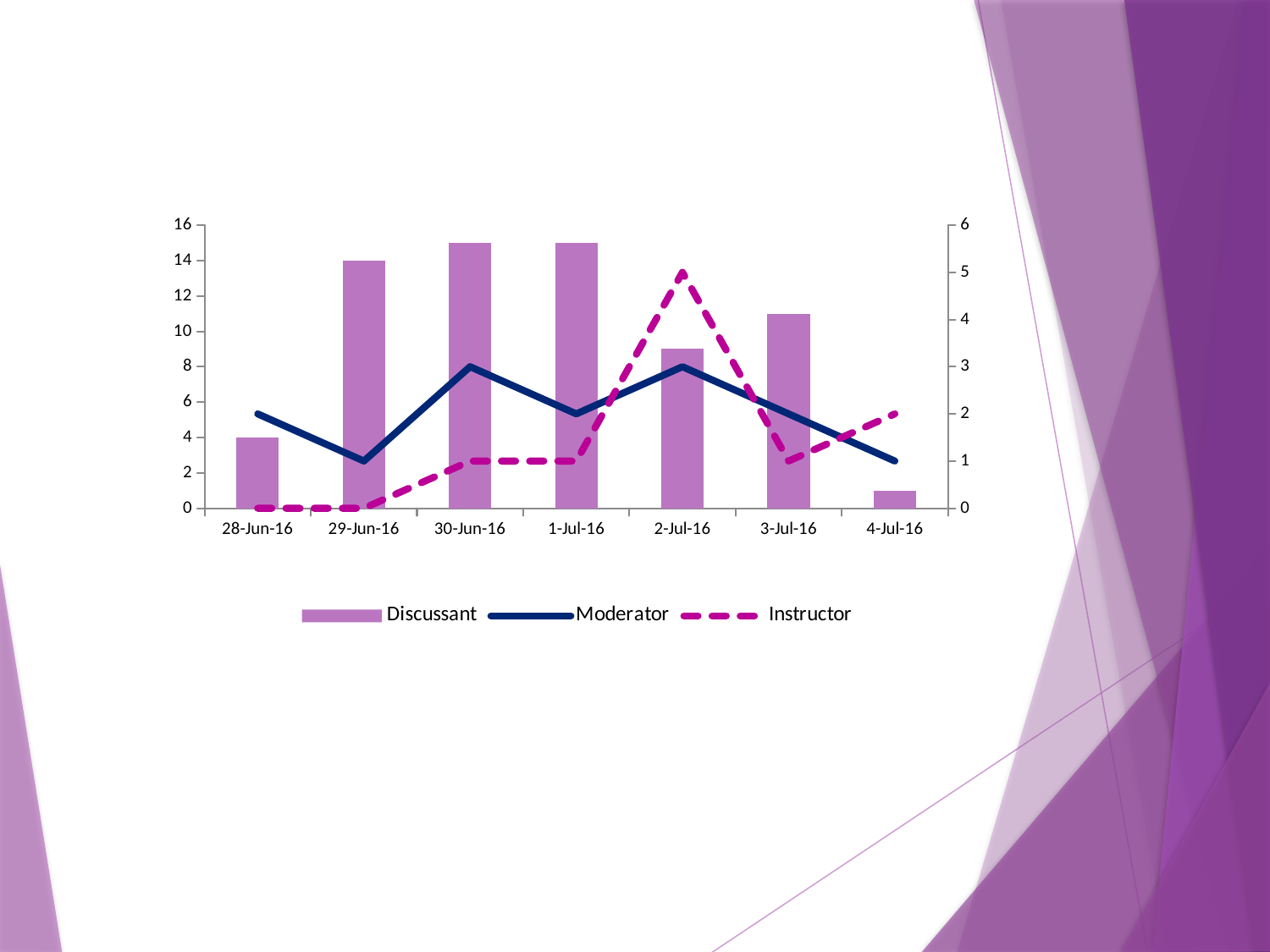
How many dates are shown on the x axis? 7 What is the Instructor value on 2-Jul-16 (right axis)? 5 On which date does the Instructor line reach its highest value? 2-Jul-16 On 1-Jul-16, which is larger: the Moderator value or the Instructor value? Moderator What is the Discussant value on 29-Jun-16? 14 Is the Discussant value on 4-Jul-16 greater or less than 2? less What is the Moderator value on 30-Jun-16 (right axis)? 3 How many series does the legend list? 3 What is the Discussant value on 28-Jun-16? 4 Is the Discussant value on 30-Jun-16 greater or less than 14? greater On which date is the Discussant value lowest? 4-Jul-16 What is the difference between the Moderator values on 30-Jun-16 and 29-Jun-16? 2